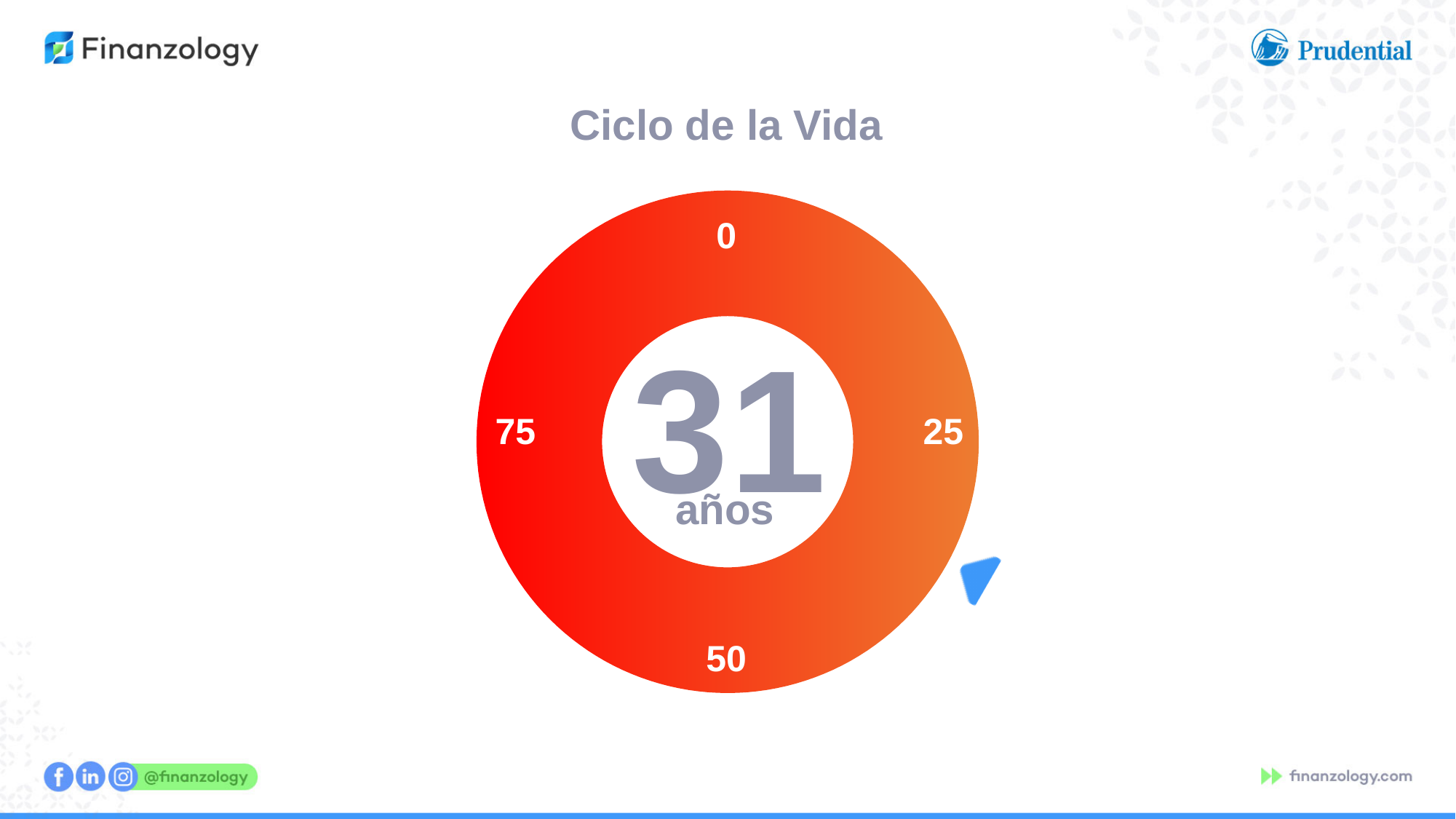
Which tick label is printed on the right side of the ring? 25 What value is printed in the centre of the ring chart? 31 Which tick label is printed at the top of the ring? 0 What is the title of the chart on the slide? Ciclo de la Vida Between which two tick labels does the blue pointer sit on the ring? 25 and 50 Which tick label is printed at the bottom of the ring? 50 Which tick label is printed on the left side of the ring? 75 What is the highest tick label printed around the ring? 75 Is the central value of 31 años greater or less than the 25 tick on the ring? greater What unit is shown under the central value of the ring chart? años How many numeric tick labels are printed around the ring? 4 Is the central value of 31 años greater or less than the 50 tick on the ring? less